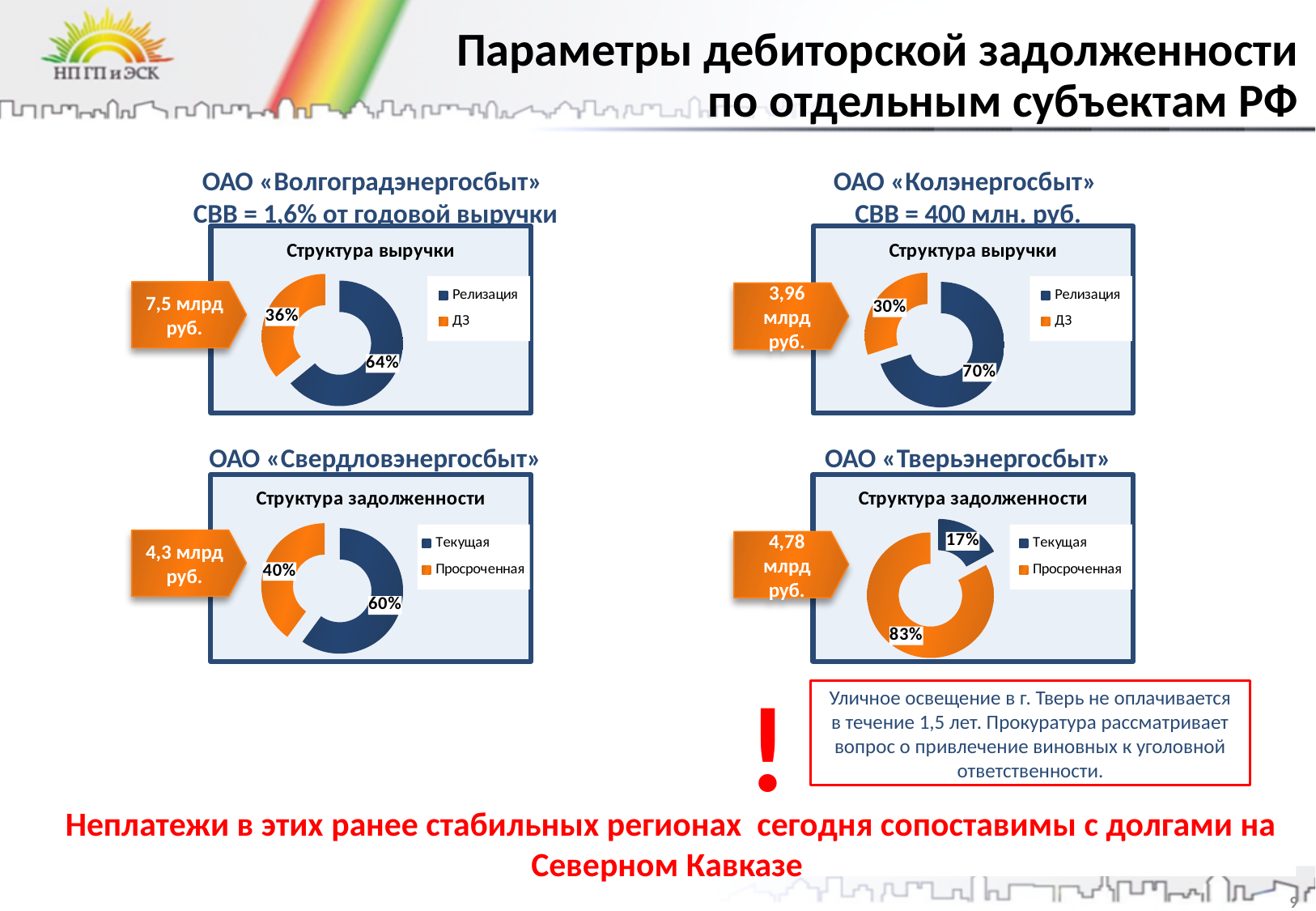
In the chart for ОАО «Тверьэнергосбыт», what share is labelled for Текущая? 17% In the chart for ОАО «Свердловэнергосбыт», which category has the smallest share? Просроченная In the chart for ОАО «Колэнергосбыт», which is larger: Релизация or ДЗ? Релизация In the chart for ОАО «Волгоградэнергосбыт», what share is labelled for ДЗ? 36% What type of chart is used for ОАО «Волгоградэнергосбыт»? Doughnut chart In the chart for ОАО «Колэнергосбыт», what share is labelled for ДЗ? 30% In the chart for ОАО «Колэнергосбыт», what share is labelled for Релизация? 70% In the chart for ОАО «Свердловэнергосбыт», what share is labelled for Просроченная? 40% In the chart for ОАО «Тверьэнергосбыт», which category has the largest share? Просроченная In the chart for ОАО «Тверьэнергосбыт», what is the difference between the Просроченная and Текущая shares? 66% In the chart for ОАО «Волгоградэнергосбыт», what share is labelled for Релизация? 64% How many entries does the legend list in the chart for ОАО «Свердловэнергосбыт»? 2